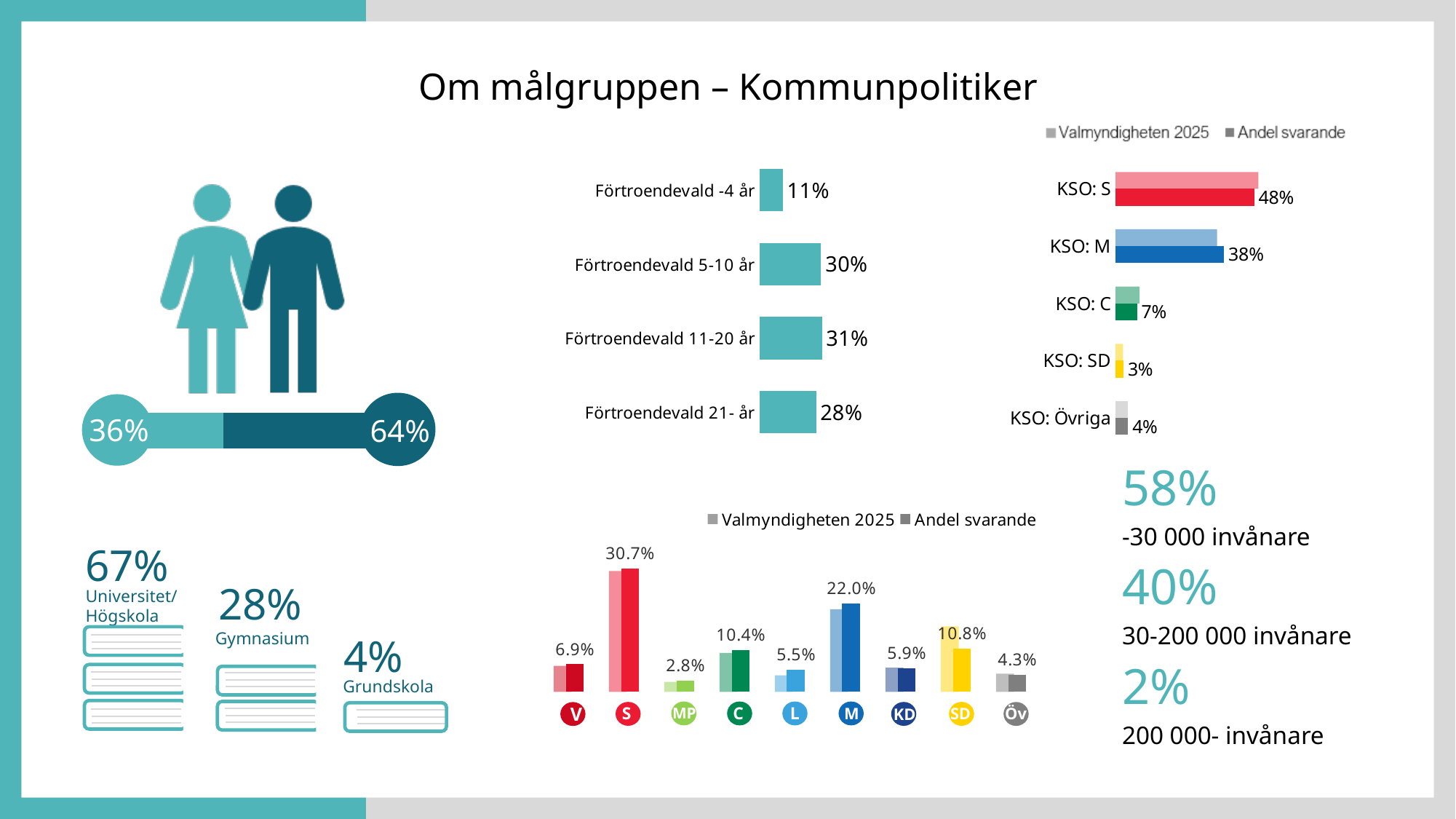
In the Förtroendevald chart in the middle of the slide, what is the difference between Förtroendevald 21- år and Förtroendevald -4 år? 17% In the party chart at the bottom of the slide, what value is labelled for S? 30.7% In the Förtroendevald chart in the middle of the slide, what is the value for Förtroendevald 5-10 år? 30% In the party chart at the bottom of the slide, which party has the lowest labelled value? MP How many categories does the Förtroendevald chart in the middle of the slide show? 4 How many series does the legend of the KSO chart at the top right list? 2 How many parties are shown on the x axis of the party chart at the bottom of the slide? 9 In the KSO chart at the top right, which is larger, the labelled value for KSO: C or for KSO: Övriga? KSO: C In the KSO chart at the top right, what is the labelled value for KSO: S? 48% In the Förtroendevald chart in the middle of the slide, which category has the highest value? Förtroendevald 11-20 år In the Förtroendevald chart in the middle of the slide, which category has the lowest value? Förtroendevald -4 år In the KSO chart at the top right, what is the labelled value for KSO: SD? 3%